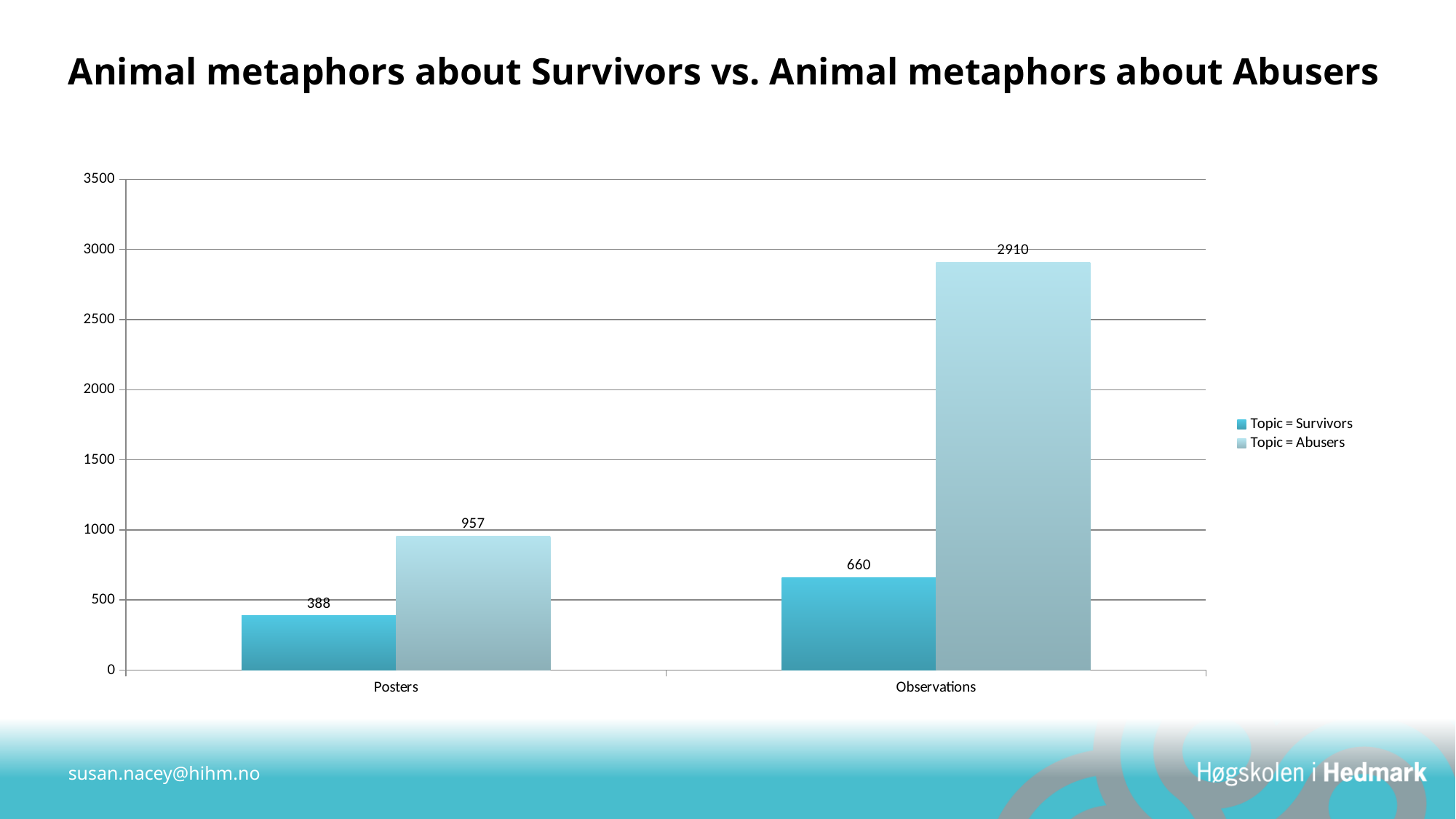
Which bar has the highest value on the chart? Topic = Abusers, Observations What is the value for Topic = Survivors in the Posters category? 388 How many categories are shown on the x axis? 2 Which is larger in the Posters category: Topic = Survivors or Topic = Abusers? Topic = Abusers How many series does the legend list? 2 What is the value for Topic = Survivors in the Observations category? 660 Which bar has the lowest value on the chart? Topic = Survivors, Posters What kind of chart is shown on the slide? Bar chart What is the difference between the Topic = Abusers and Topic = Survivors values in the Posters category? 569 What is the difference between the Topic = Abusers and Topic = Survivors values in the Observations category? 2250 What is the value for Topic = Abusers in the Observations category? 2910 What is the value for Topic = Abusers in the Posters category? 957